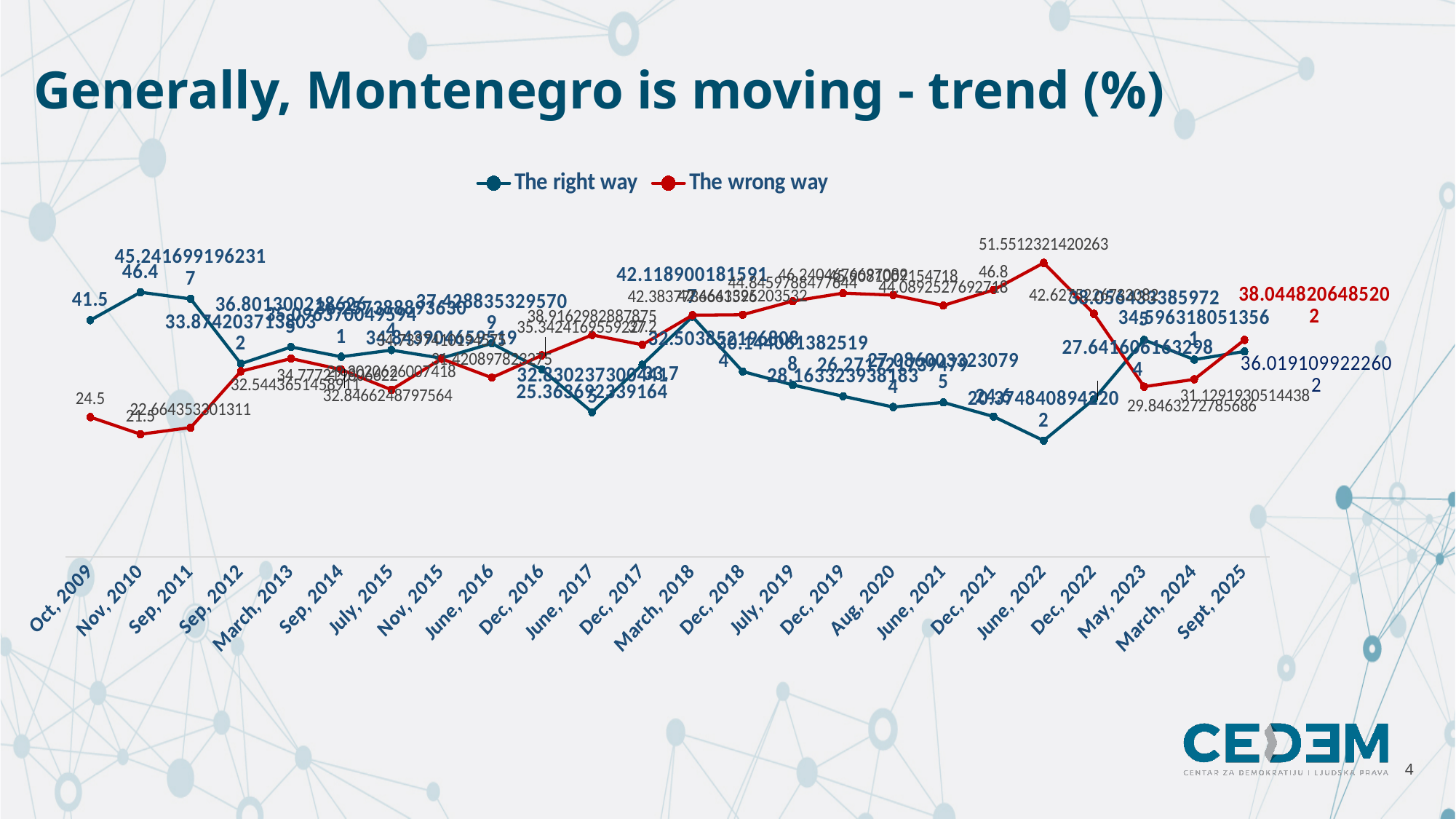
How many series does the legend list? 2 What is the value for 'The wrong way' in Nov, 2010? 21.5 What is the value for 'The wrong way' in Dec, 2021? 46.8 What is the value for 'The right way' in Oct, 2009? 41.5 In which period does 'The right way' reach its lowest value? June, 2022 How many time periods are shown on the x axis? 24 What is the value for 'The right way' in Nov, 2010? 46.4 What is the difference between 'The right way' and 'The wrong way' in Oct, 2009? 17 Which colour is used for 'The wrong way' series? Red In which period does 'The wrong way' reach its highest value? June, 2022 What kind of chart is shown on the slide? Line chart In Sept, 2025, which series has the larger value, 'The right way' or 'The wrong way'? The wrong way